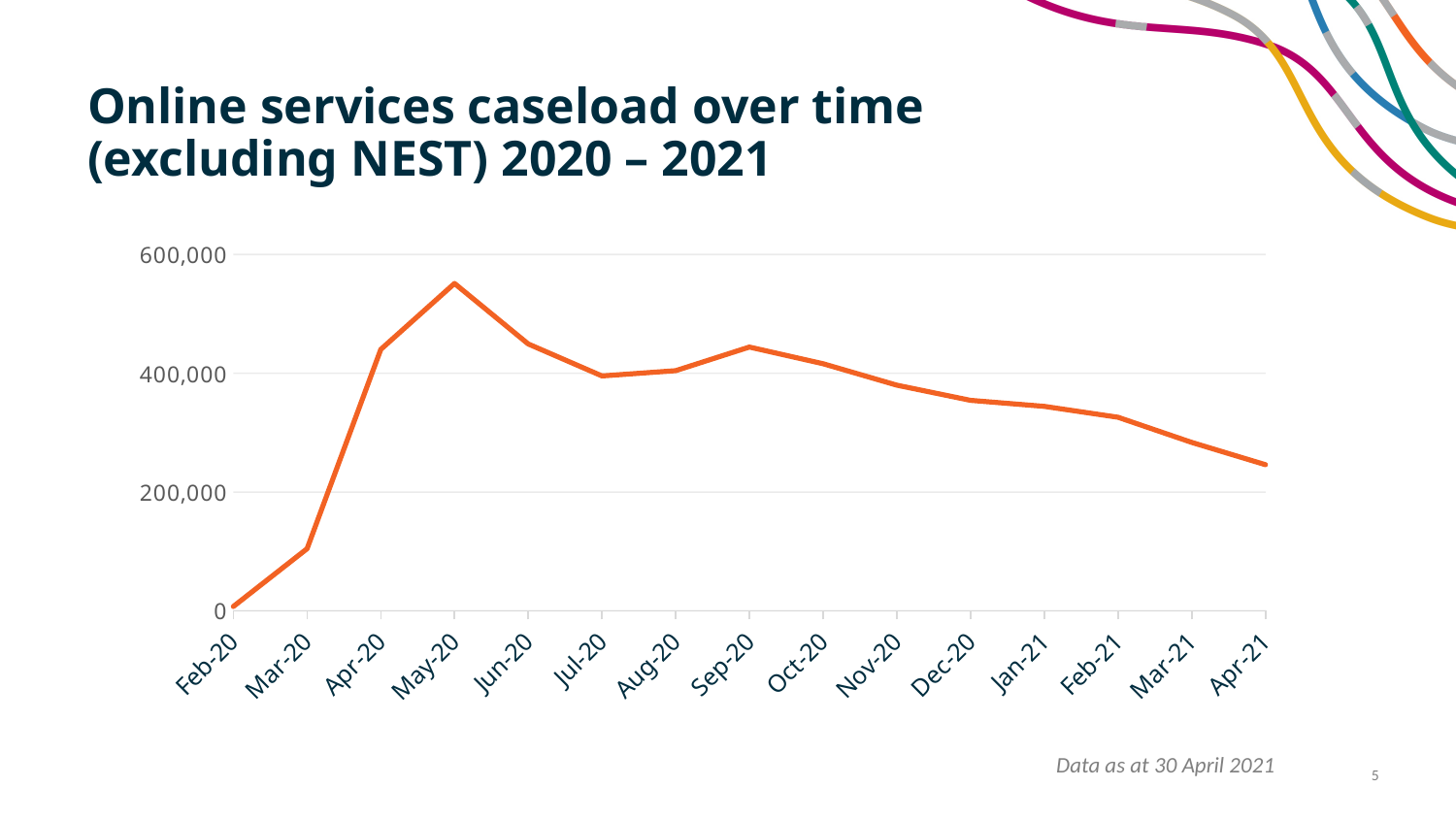
In which month is the online services caseload lowest? Feb-20 Is the value for Dec-20 greater or less than 400,000? less Is the value for Mar-20 greater or less than 200,000? less What is the title of the chart? Online services caseload over time (excluding NEST) 2020 – 2021 Is the value for May-20 greater or less than 400,000? greater What kind of chart is shown on the slide? Line chart Which month has the larger caseload, Mar-20 or Apr-20? Apr-20 Which month has the larger caseload, May-20 or Apr-21? May-20 How many months are plotted along the x axis? 15 Does the caseload rise or fall from Sep-20 to Apr-21? Fall In which month is the online services caseload highest? May-20